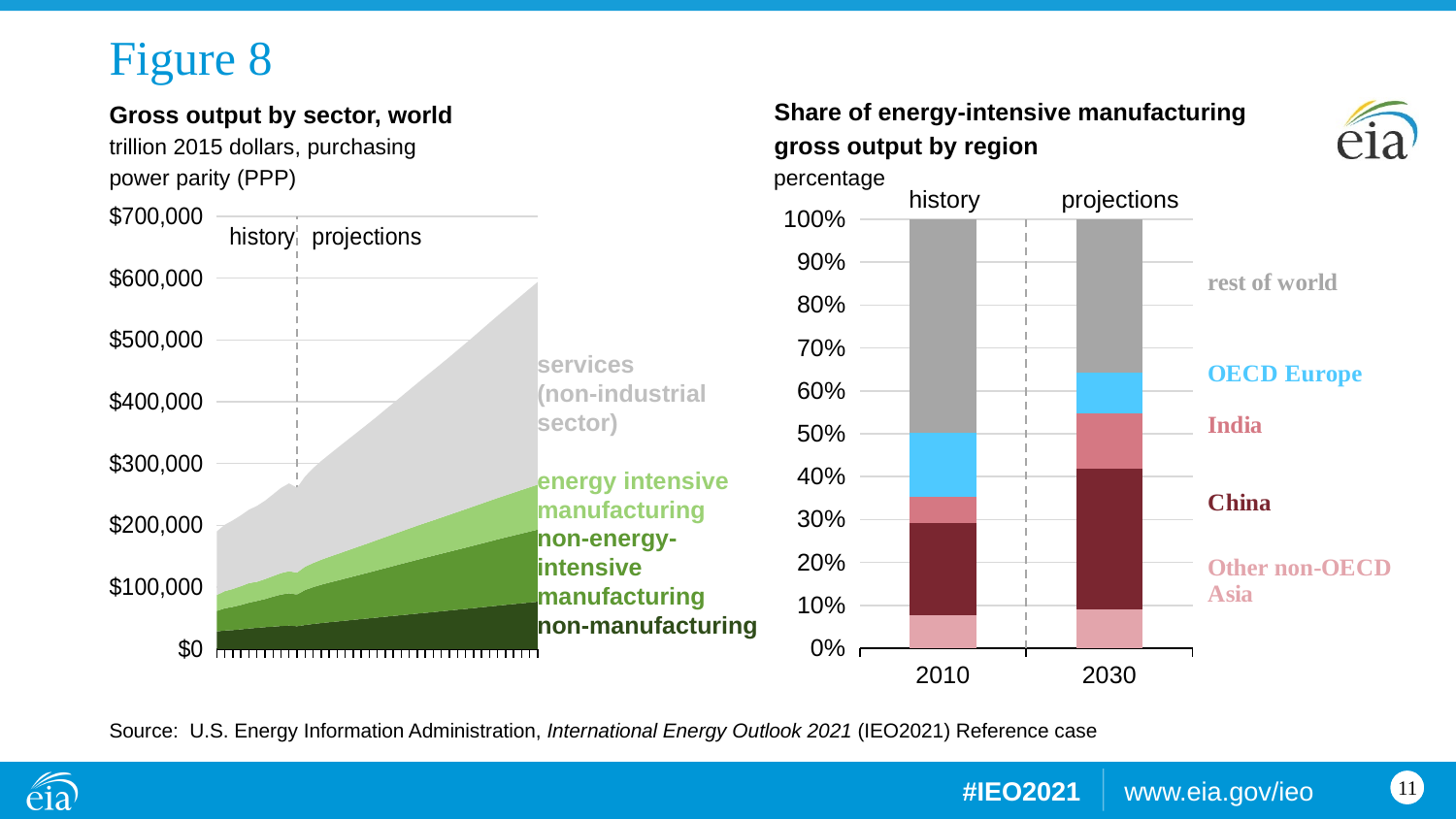
What kind of chart is the 'Gross output by sector, world' chart on the left? stacked area chart In the 'Share of energy-intensive manufacturing gross output by region' chart, is the rest of world share in 2010 greater or less than 40%? greater In the 'Share of energy-intensive manufacturing gross output by region' chart, is the rest of world share larger in 2010 or in 2030? 2010 What kind of chart is the 'Share of energy-intensive manufacturing gross output by region' chart on the right? stacked bar chart In the 'Gross output by sector, world' chart, which sector has the largest gross output at the end of the projection period? services (non-industrial sector) In the 'Share of energy-intensive manufacturing gross output by region' chart, is China's share larger in 2010 or in 2030? 2030 In the 'Share of energy-intensive manufacturing gross output by region' chart, how many regions are shown in the legend? 5 In the 'Share of energy-intensive manufacturing gross output by region' chart, how many years (bars) are shown? 2 In the 'Gross output by sector, world' chart, is total gross output at the end of the projection period greater or less than $500,000? greater In the 'Gross output by sector, world' chart, does total gross output rise or fall over time? rise In the 'Gross output by sector, world' chart, how many sectors are plotted? 4